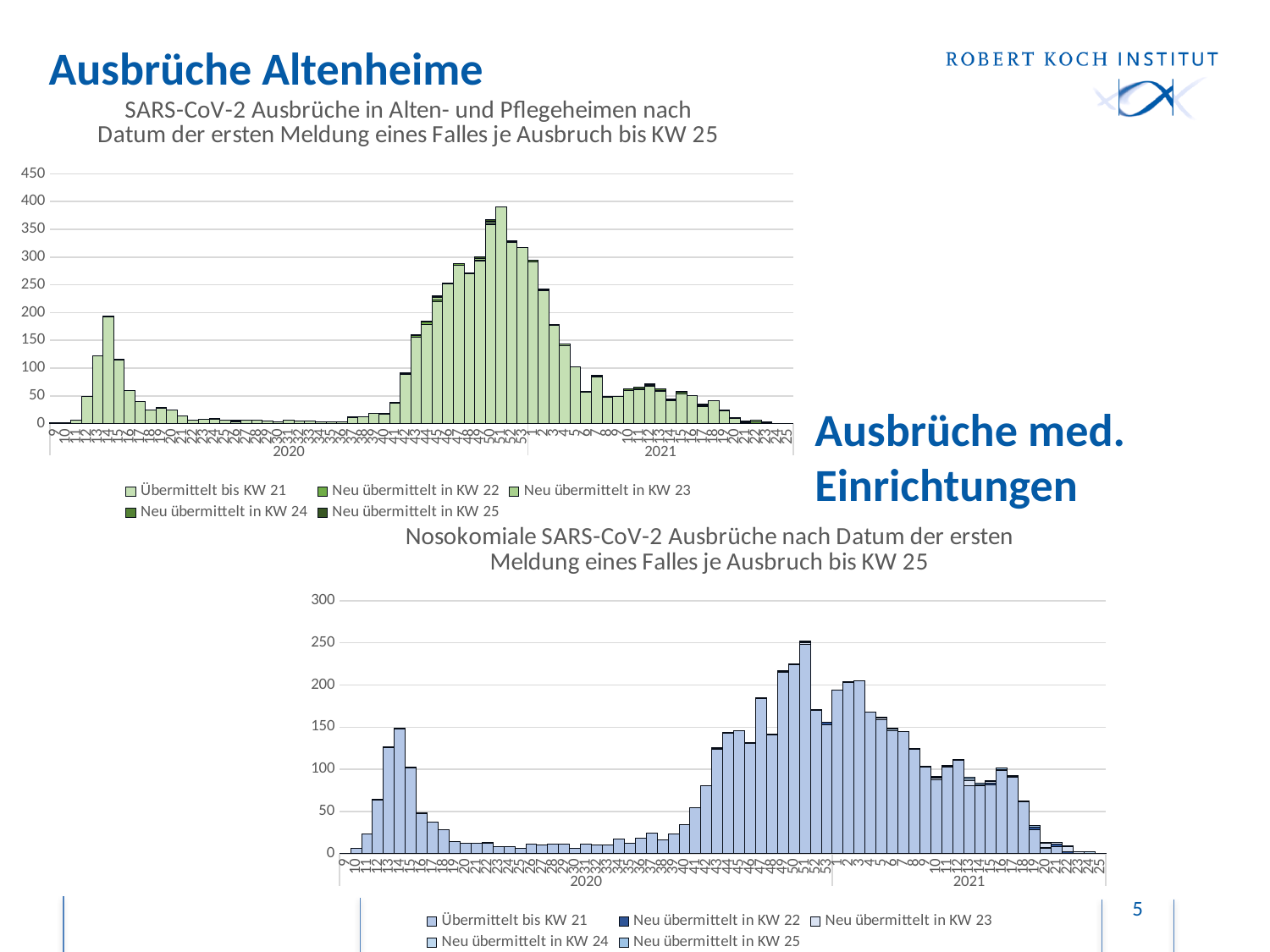
In the bottom chart (Nosokomiale Ausbrüche), is the value of the highest bar greater or less than 200? greater In the bottom chart (Nosokomiale Ausbrüche), is the highest bar of the spring 2020 wave greater or less than 200? less What kind of chart is the top chart titled 'SARS-CoV-2 Ausbrüche in Alten- und Pflegeheimen'? bar chart How many series does the legend of the top chart (Alten- und Pflegeheime) list? 5 In the bottom chart (Nosokomiale Ausbrüche), in which year does the highest bar occur? 2020 What is the first legend entry of the top chart (Alten- und Pflegeheime)? Übermittelt bis KW 21 In the top chart (Alten- und Pflegeheime), is the highest bar of the spring 2020 wave greater or less than 250? less What kind of chart is the bottom chart titled 'Nosokomiale SARS-CoV-2 Ausbrüche'? bar chart How many series does the legend of the bottom chart (Nosokomiale Ausbrüche) list? 5 What is the maximum value shown on the y axis of the bottom chart (Nosokomiale Ausbrüche)? 300 In the top chart (Alten- und Pflegeheime), in which year does the highest bar occur? 2020